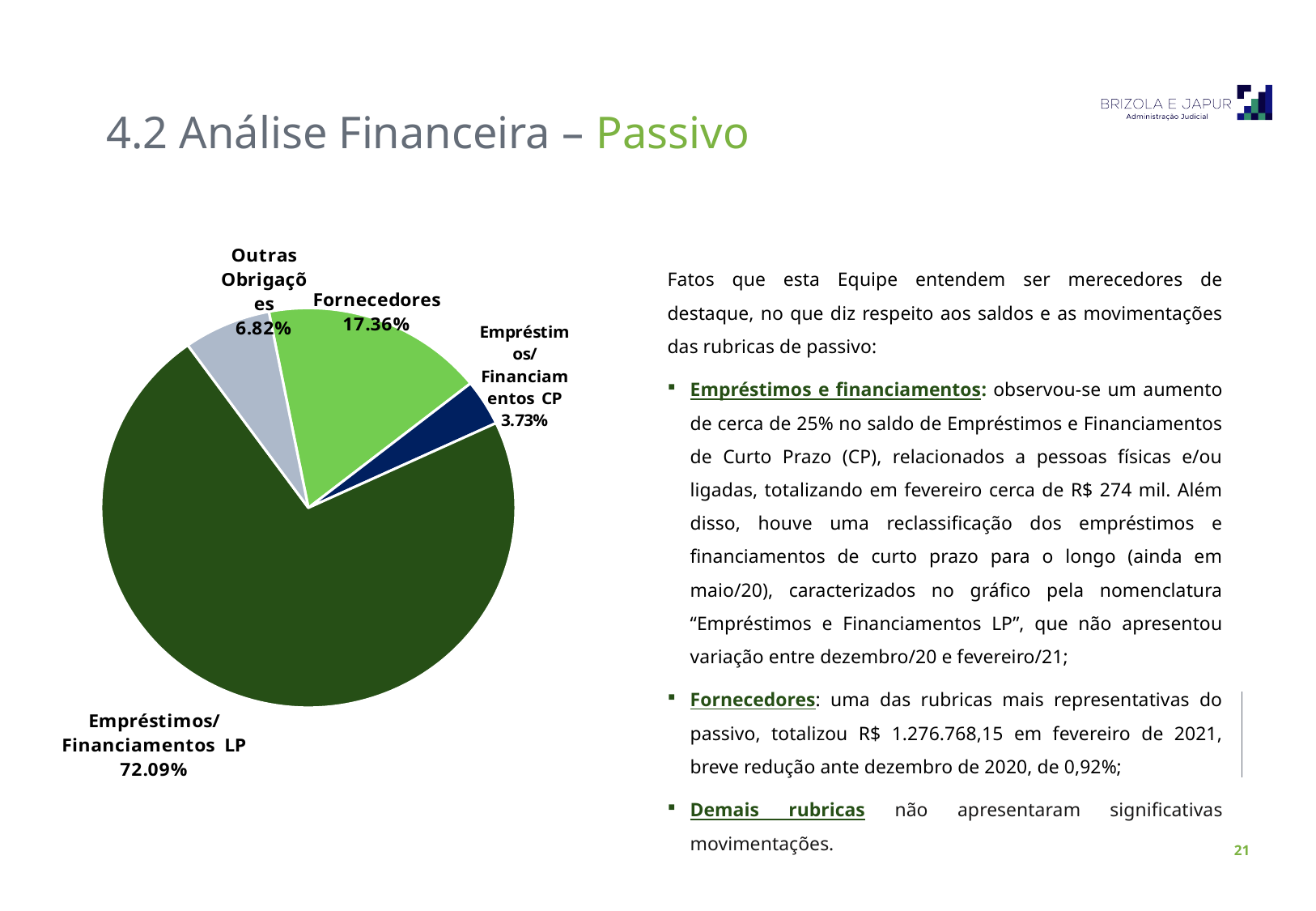
Which slice of the pie chart is the largest? Empréstimos/Financiamentos LP What kind of chart is shown on the slide? Pie chart What colour is the Fornecedores slice in the pie chart? Light green What share of the pie does Empréstimos/Financiamentos LP represent? 72.09% Which is larger, the share of Outras Obrigações or the share of Empréstimos/Financiamentos CP? Outras Obrigações What is the value shown for Empréstimos/Financiamentos CP? 3.73% What is the value shown for Fornecedores? 17.36% What is the difference between the shares of Fornecedores and Outras Obrigações? 10.54% How many slices does the pie chart have? 4 What is the difference between the shares of Empréstimos/Financiamentos LP and Fornecedores? 54.73% What is the value shown for Outras Obrigações? 6.82% Which slice of the pie chart is the smallest? Empréstimos/Financiamentos CP